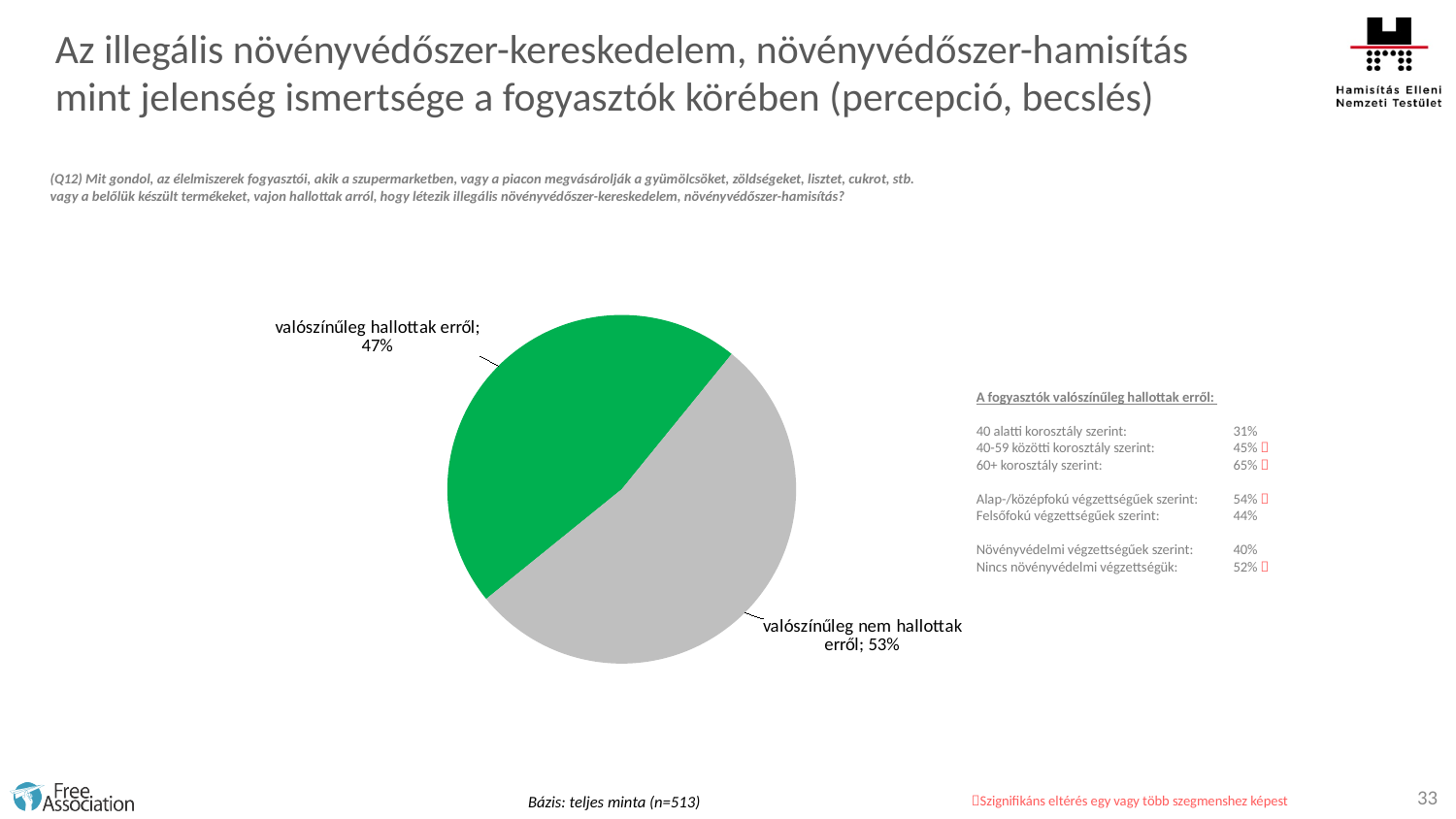
What kind of chart is shown on the slide? pie chart Which slice of the pie chart is the largest? valószínűleg nem hallottak erről What is the value for "valószínűleg nem hallottak erről"? 53% Which slice of the pie chart is the smallest? valószínűleg hallottak erről How many slices does the pie chart have? 2 What colour is the "valószínűleg hallottak erről" slice? green Which is larger: "valószínűleg hallottak erről" or "valószínűleg nem hallottak erről"? valószínűleg nem hallottak erről What is the value for "valószínűleg hallottak erről"? 47% What is the difference between the "valószínűleg nem hallottak erről" and "valószínűleg hallottak erről" slices? 6% What share of the pie does "valószínűleg hallottak erről" represent? 47% What colour is the "valószínűleg nem hallottak erről" slice? grey